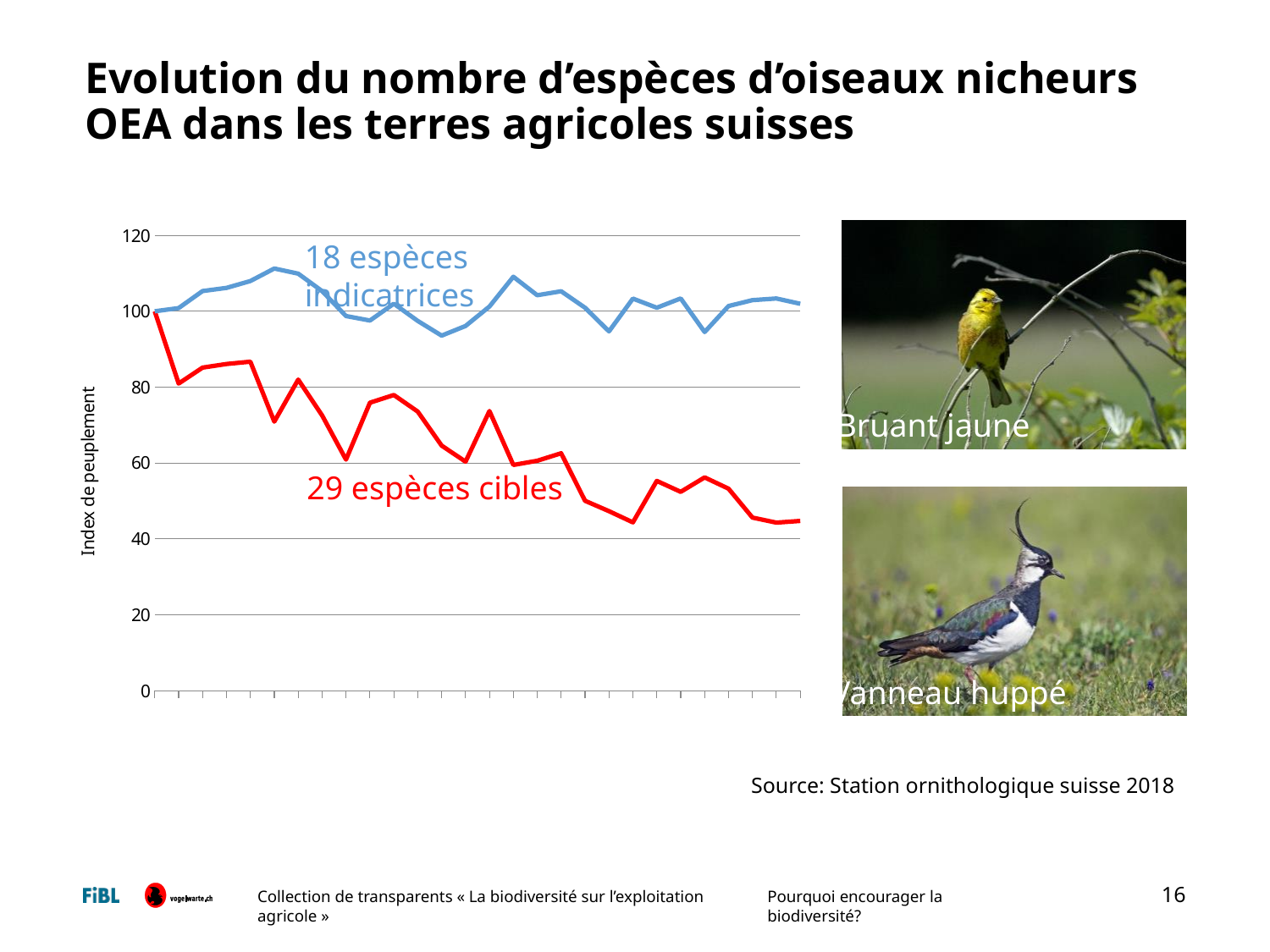
How many data series are plotted on the chart? 2 What kind of chart is shown on the slide? line chart What is the label of the blue series on the chart? 18 espèces indicatrices What is the label of the red series on the chart? 29 espèces cibles What is the highest value shown on the vertical axis? 120 Is the lowest point of the red series (29 espèces cibles) greater or less than 60? less Is the final value of the red series (29 espèces cibles) greater or less than 60? less Which series is lower at the right end of the chart, 18 espèces indicatrices or 29 espèces cibles? 29 espèces cibles Is the final value of the blue series (18 espèces indicatrices) greater or less than 80? greater What is the label of the vertical axis? Index de peuplement At what value do both series start at the left of the chart? 100 Does the red series (29 espèces cibles) rise or fall along the x axis overall? fall